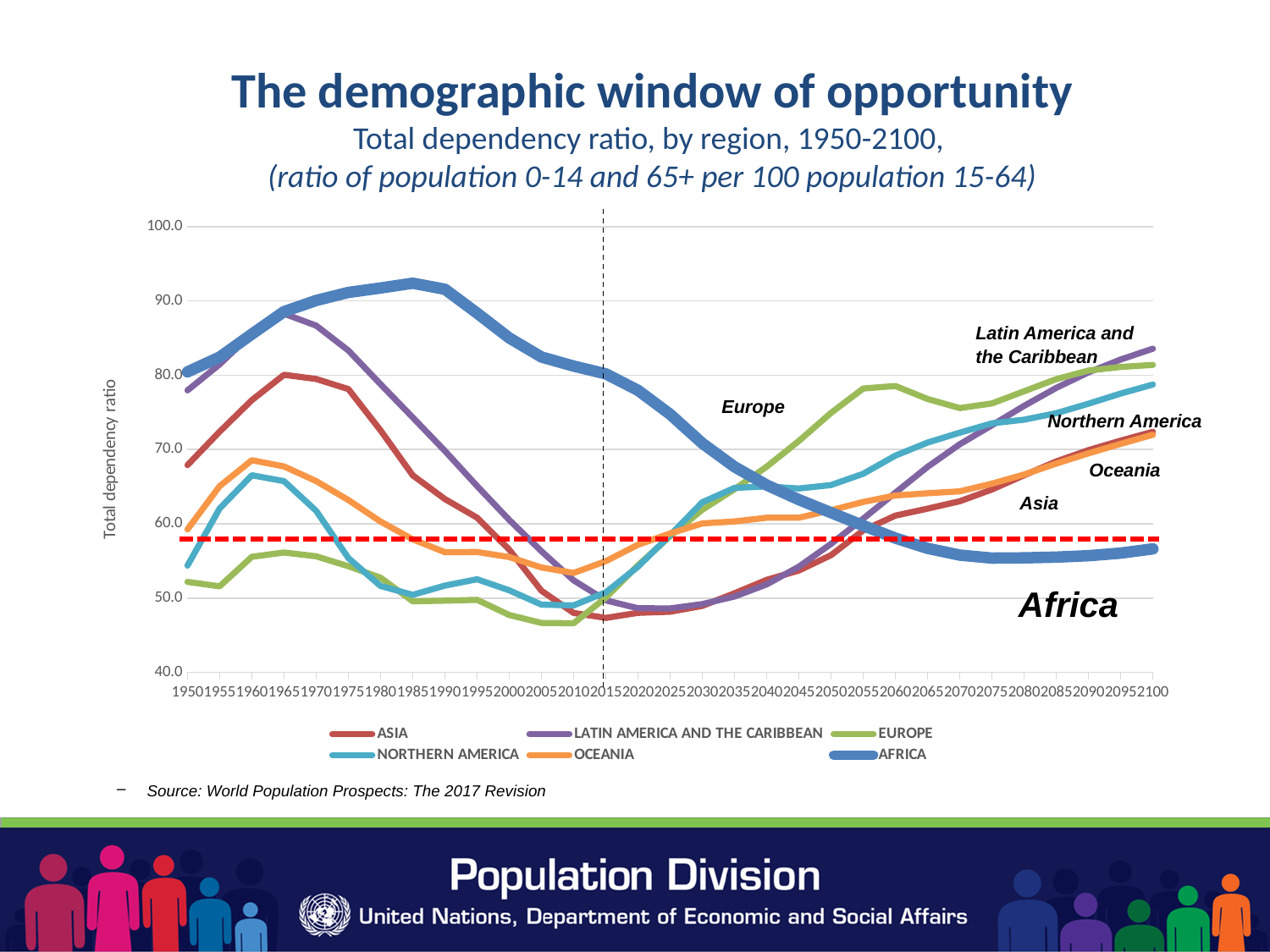
Is the value for Africa in 2100 greater or less than 60? less Does the Africa line rise or fall between 1985 and 2075? fall What kind of chart is shown on the slide? line chart Is the value for Africa in 1985 greater or less than 90? greater Which region has the highest total dependency ratio in 2050? Europe Is the value for Europe in 2010 greater or less than 50? less Which region has the highest total dependency ratio in 1985? Africa How many series does the legend list? 6 Which region has the lowest total dependency ratio in 2100? Africa How many years are marked along the x axis? 31 In 1950, which is larger: the value for Africa or the value for Asia? Africa What is the label on the vertical axis? Total dependency ratio